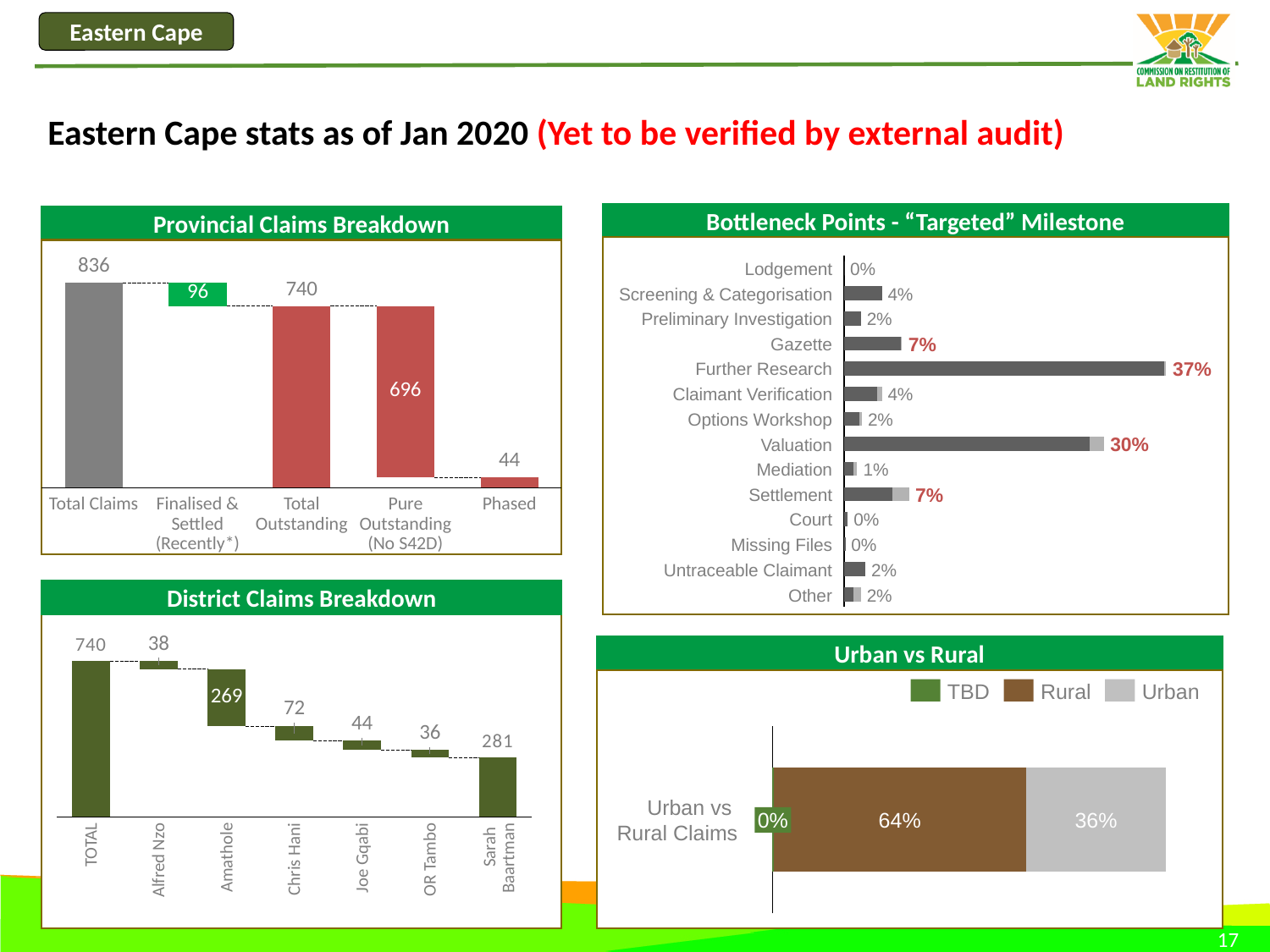
In the Urban vs Rural chart, what is the share for Rural? 64% How many categories are shown in the Bottleneck Points chart? 14 In the Provincial Claims Breakdown chart, what is the value for Pure Outstanding (No S42D)? 696 How many series does the legend of the Urban vs Rural chart list? 3 In the District Claims Breakdown chart, which district has the lowest value? OR Tambo In the Provincial Claims Breakdown chart, what is the difference between Total Claims and Total Outstanding? 96 In the District Claims Breakdown chart, what is the difference between Amathole and Alfred Nzo? 231 In the Bottleneck Points chart, which category has the highest percentage? Further Research In the Bottleneck Points chart, what is the value for Valuation? 30% In the District Claims Breakdown chart, what is the value for Chris Hani? 72 In the Provincial Claims Breakdown chart, what is the value for Total Claims? 836 In the District Claims Breakdown chart, which district has the highest value? Sarah Baartman